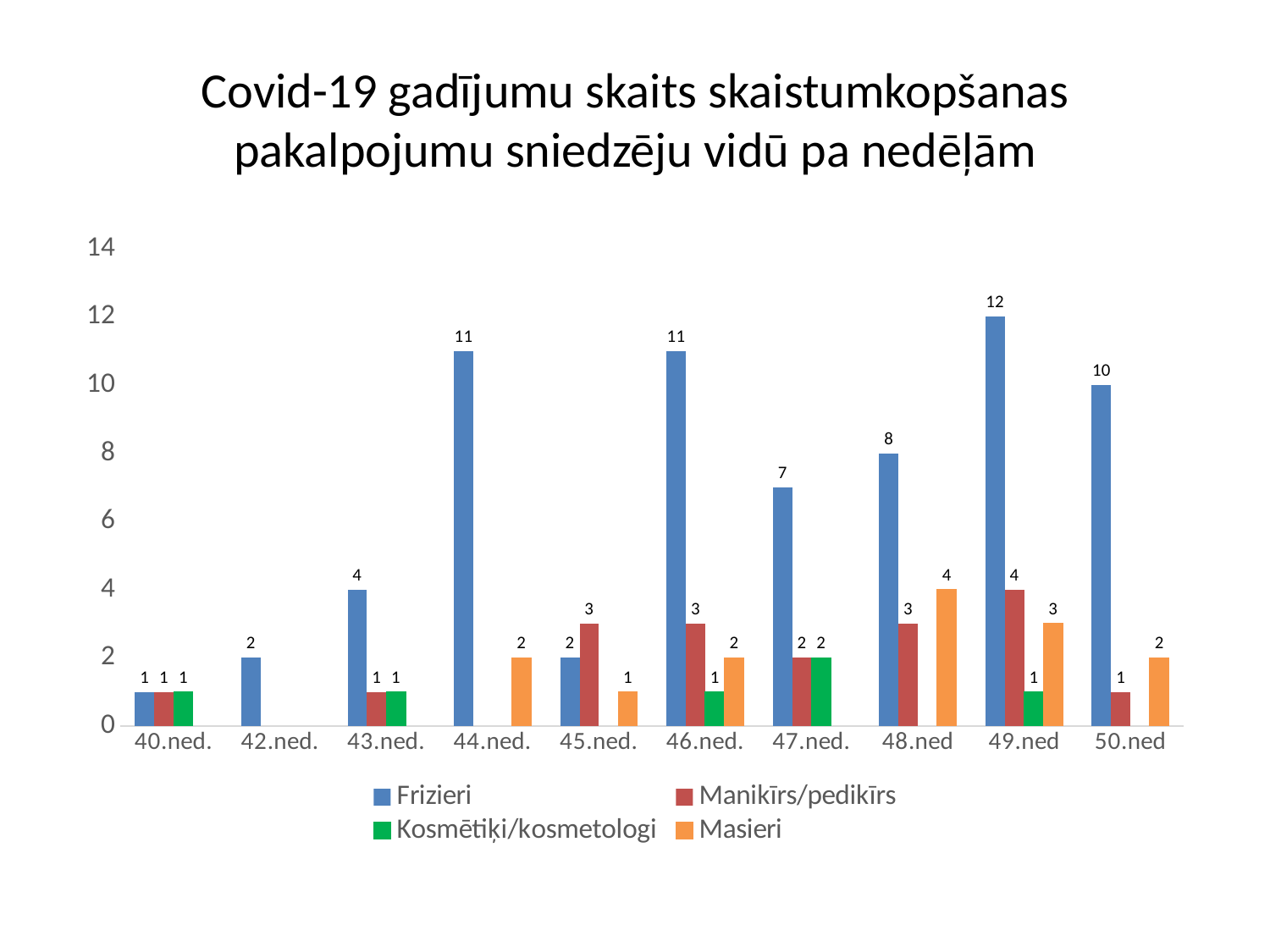
How many weeks are shown on the x axis? 10 What is the value for Frizieri in 49.ned? 12 Which series has the lowest value in 46.ned.? Kosmētiķi/kosmetologi Is the value for Frizieri in 44.ned. greater or less than 10? greater Which is larger in 45.ned.: Frizieri or Manikīrs/pedikīrs? Manikīrs/pedikīrs What kind of chart is shown on the slide? bar chart In which week does Frizieri reach its highest value? 49.ned What is the value for Masieri in 48.ned? 4 What is the value for Manikīrs/pedikīrs in 45.ned.? 3 How many series does the legend list? 4 Which colour represents Masieri in the chart? orange What is the difference between the Frizieri values in 49.ned and 50.ned? 2